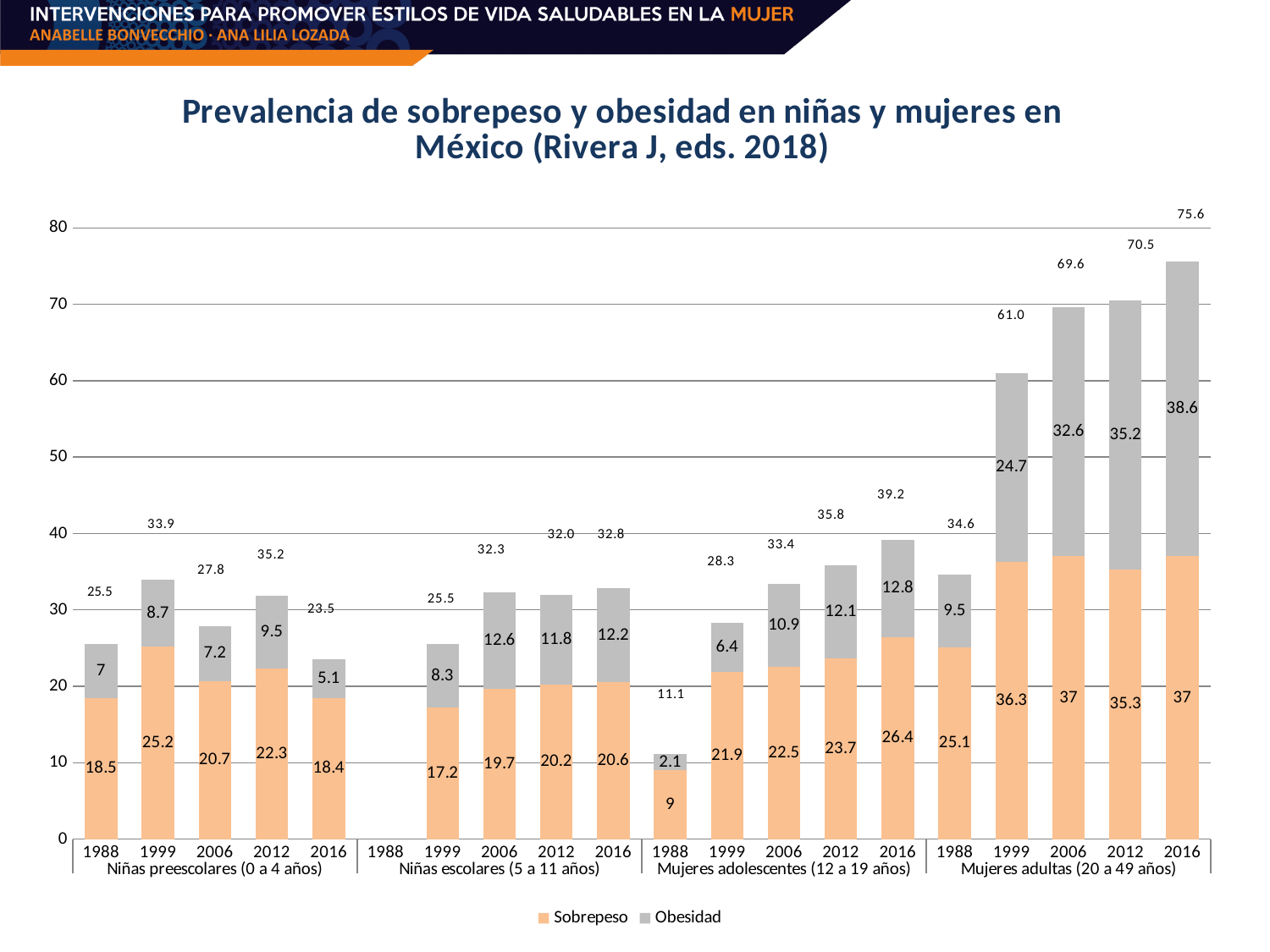
What is the Obesidad value for Niñas preescolares (0 a 4 años) in 1999? 8.7 What is the Sobrepeso value for Mujeres adultas (20 a 49 años) in 2016? 37 What is the difference between the Obesidad values for Mujeres adultas (20 a 49 años) in 2016 and 2012? 3.4 What is the Obesidad value for Mujeres adolescentes (12 a 19 años) in 1988? 2.1 How many series does the legend list? 2 Which year has the lowest total bar in the Mujeres adolescentes (12 a 19 años) group? 1988 Is the total bar for Mujeres adolescentes (12 a 19 años) in 2016 greater or less than 30? greater Do the total bars for Mujeres adultas (20 a 49 años) rise or fall from 1988 to 2016? Rise Which is larger, the Sobrepeso value for Niñas preescolares (0 a 4 años) in 1999 or in 2016? 1999 What kind of chart is shown on the slide? Stacked bar chart Which year has the highest total bar in the Mujeres adultas (20 a 49 años) group? 2016 What is the total of the stacked bar for Mujeres adultas (20 a 49 años) in 2016? 75.6